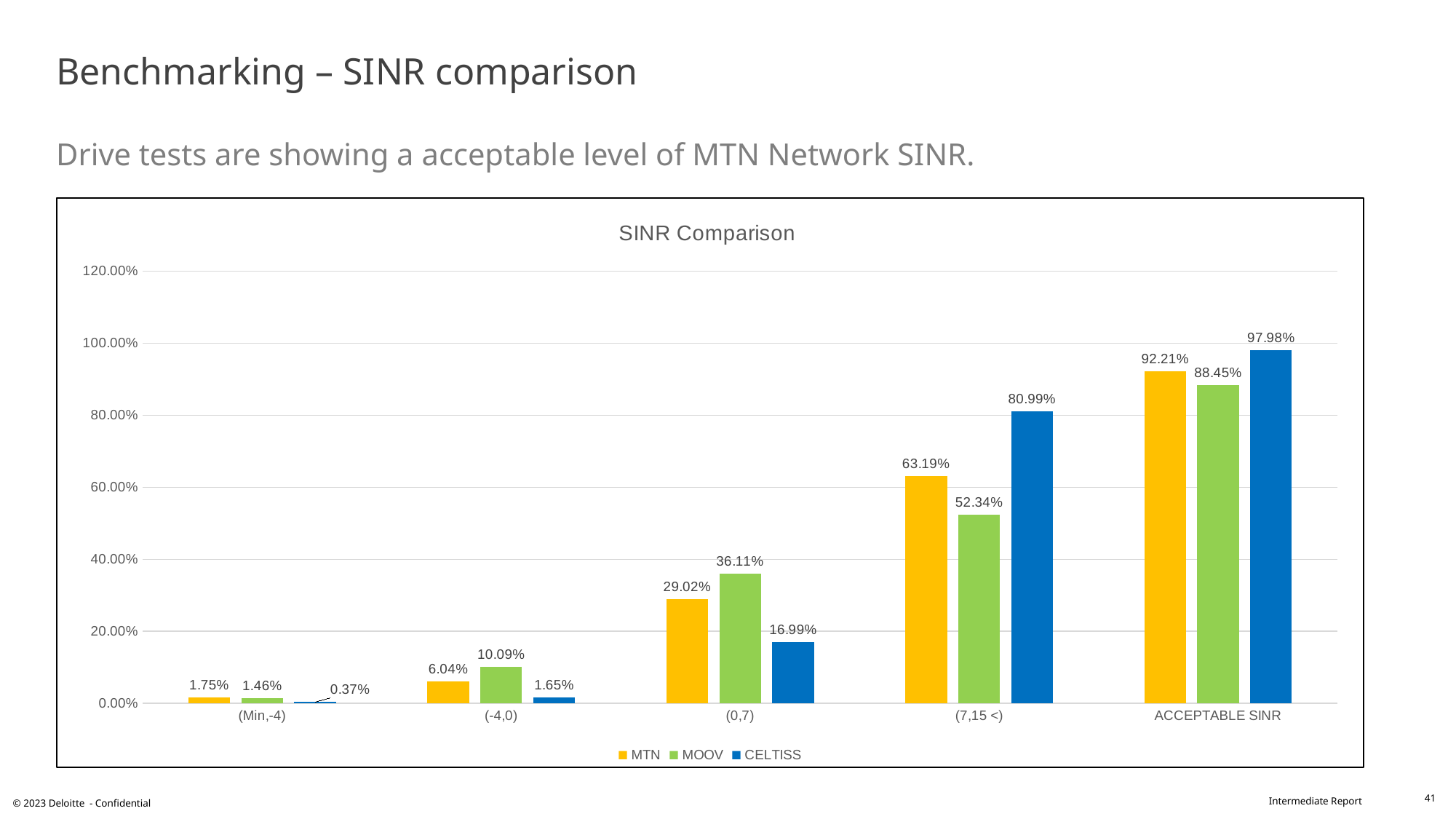
Which series has the lowest value in the (Min,-4) category? CELTISS Do the MTN values rise or fall from the (Min,-4) category to the ACCEPTABLE SINR category? Rise What is the value for CELTISS in the ACCEPTABLE SINR category? 97.98% Which is larger in the (0,7) category, the MTN value or the CELTISS value? MTN Which series has the highest value in the (7,15 <) category? CELTISS What is the value for MTN in the (-4,0) category? 6.04% What is the title of the chart? SINR Comparison How many series does the legend list? 3 What is the value for MOOV in the (0,7) category? 36.11% What is the difference between the CELTISS and MTN values in the ACCEPTABLE SINR category? 5.77% What type of chart is shown on the slide? Bar chart How many categories are shown on the x axis? 5